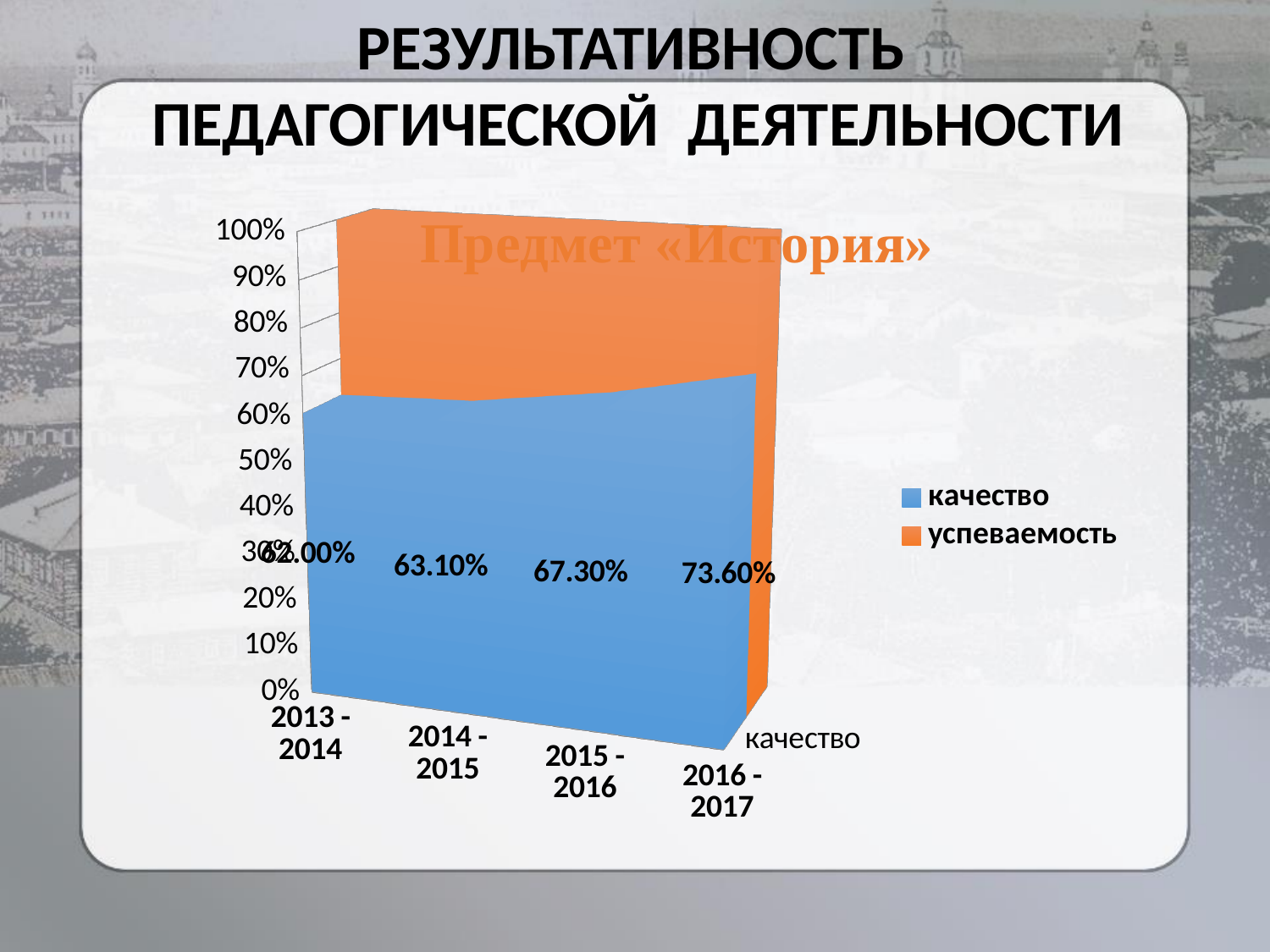
What is the value of качество for 2015 - 2016? 67.30% What is the value of качество for 2016 - 2017? 73.60% What is the difference between качество in 2016 - 2017 and in 2015 - 2016? 6.30% Does качество rise or fall from 2013 - 2014 to 2016 - 2017? rise What is the difference between качество in 2015 - 2016 and in 2014 - 2015? 4.20% How many academic years are shown on the x axis? 4 In which academic year is качество highest? 2016 - 2017 Is the value of успеваемость for 2014 - 2015 greater or less than 90%? greater What is the value of качество for 2014 - 2015? 63.10% How many series does the legend list? 2 Which year has the larger качество value, 2014 - 2015 or 2016 - 2017? 2016 - 2017 What kind of chart is shown on the slide? area chart